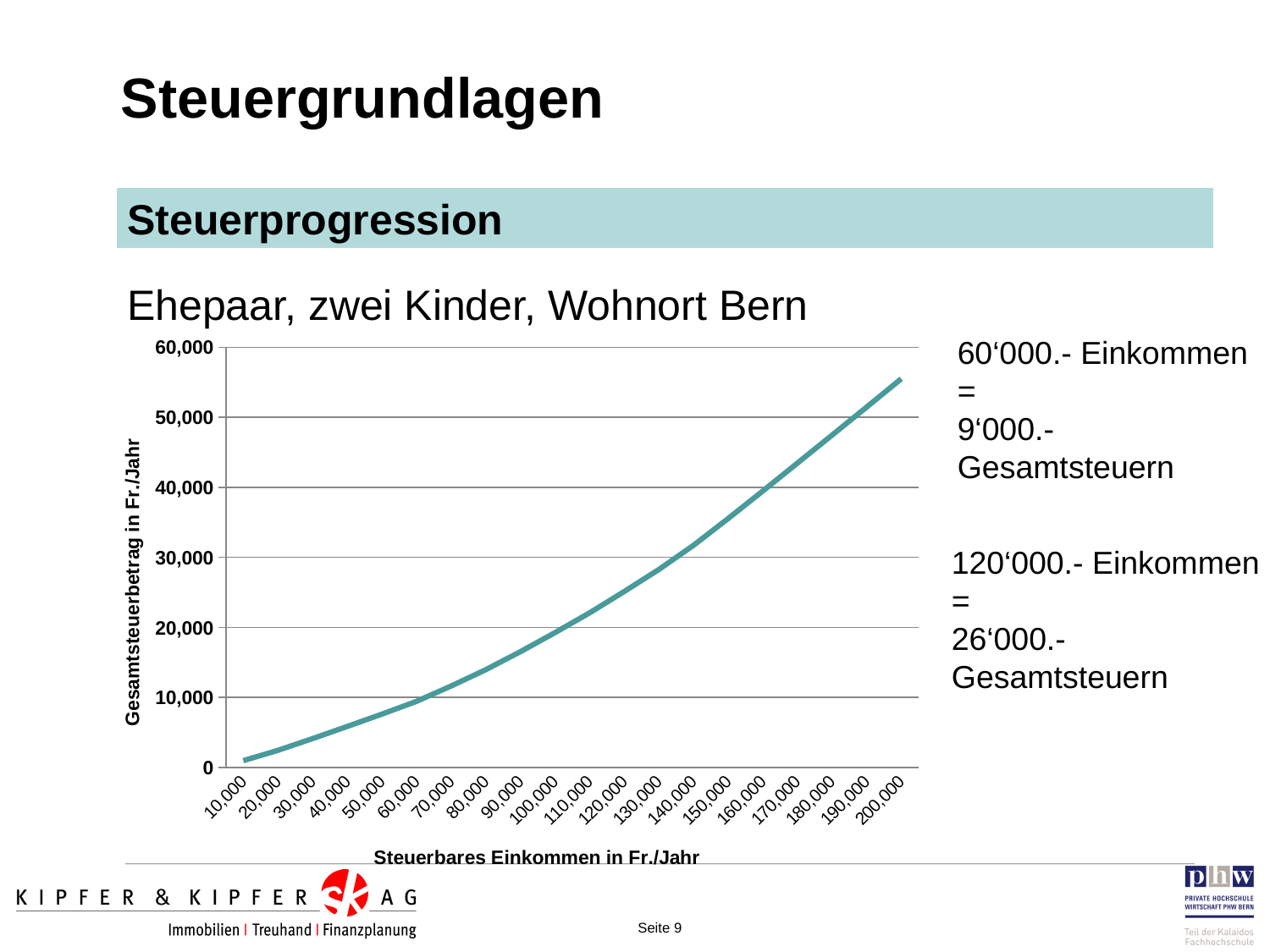
Which is larger, the value for 80,000 or the value for 160,000? 160,000 Do the values on the chart rise or fall as taxable income increases along the x axis? rise What is the title of the y axis of the chart? Gesamtsteuerbetrag in Fr./Jahr How many income points are labelled on the x axis of the chart? 20 At which taxable income is the total tax amount lowest on the chart? 10,000 What kind of chart is shown on the slide? line chart Is the value for 120,000 greater or less than 30,000? less Is the value for 180,000 greater or less than 40,000? greater Is the value for 150,000 greater or less than 30,000? greater At which taxable income is the total tax amount highest on the chart? 200,000